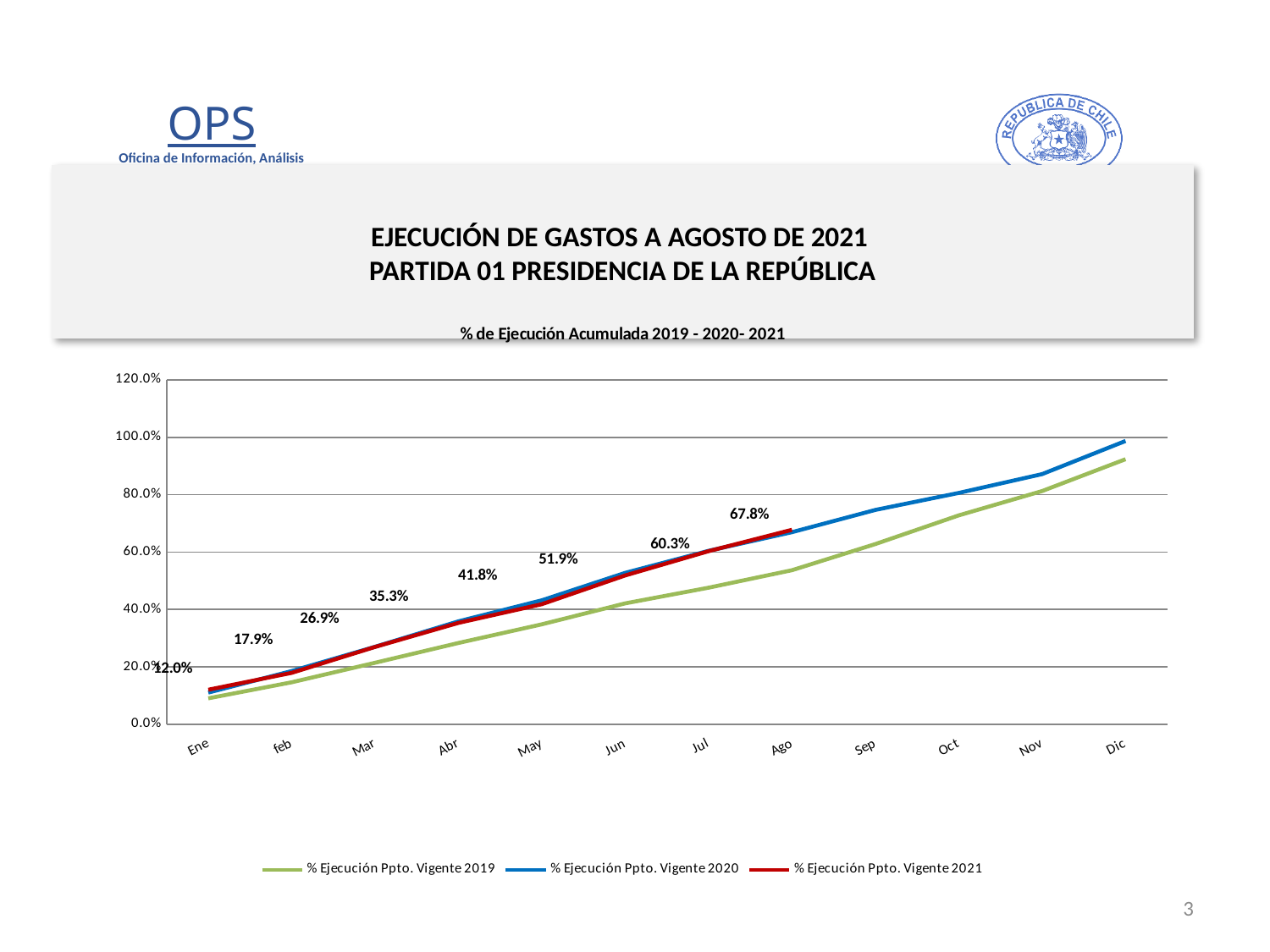
What is the difference between the % Ejecución Ppto. Vigente 2021 values for Ago and Jul? 7.5% What is the value of % Ejecución Ppto. Vigente 2021 for Jun? 51.9% Which series is higher in Nov, % Ejecución Ppto. Vigente 2019 or % Ejecución Ppto. Vigente 2020? % Ejecución Ppto. Vigente 2020 What is the value of % Ejecución Ppto. Vigente 2021 for Ago? 67.8% What kind of chart is shown on the slide? Line chart How many series does the legend list? 3 What is the difference between the % Ejecución Ppto. Vigente 2021 values for Abr and Mar? 8.4% What is the value of % Ejecución Ppto. Vigente 2021 for Ene? 12.0% Is the value of % Ejecución Ppto. Vigente 2020 for Dic greater or less than 80.0%? greater What is the value of % Ejecución Ppto. Vigente 2021 for May? 41.8% Which month has the highest labelled value for % Ejecución Ppto. Vigente 2021? Ago Which month has the lowest labelled value for % Ejecución Ppto. Vigente 2021? Ene